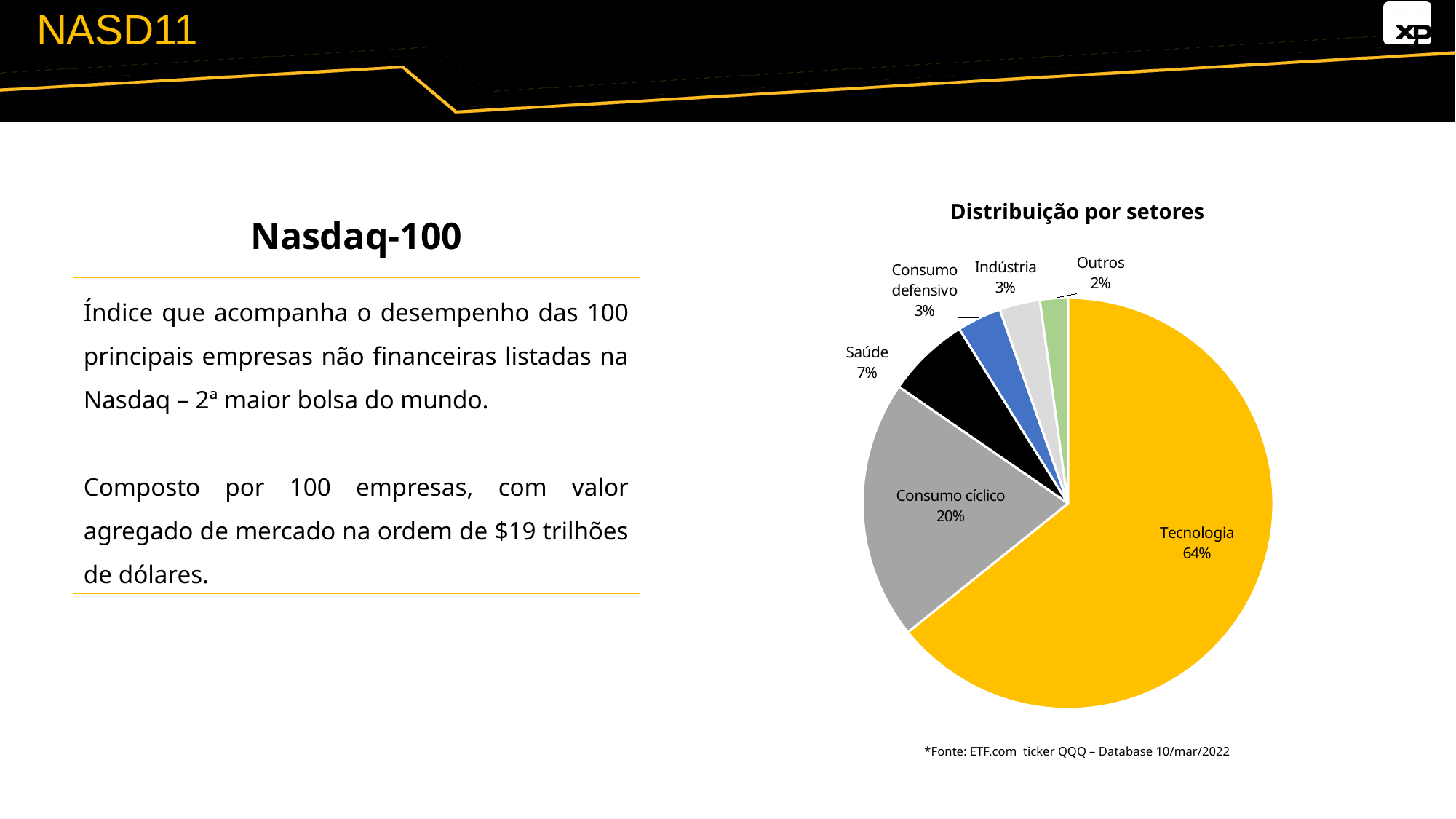
Which sector has the largest slice of the pie? Tecnologia What is the title of the chart? Distribuição por setores How many sectors are shown in the pie chart? 6 What is the difference between the Tecnologia and Consumo cíclico shares? 44% What share of the pie does Tecnologia hold? 64% What type of chart is shown on the slide? Pie chart Which is larger, Saúde or Indústria? Saúde What is the value shown for Consumo cíclico? 20% What is the value shown for Outros? 2% What is the value shown for Saúde? 7% What colour is the Tecnologia slice? Yellow Which sector has the smallest slice of the pie? Outros